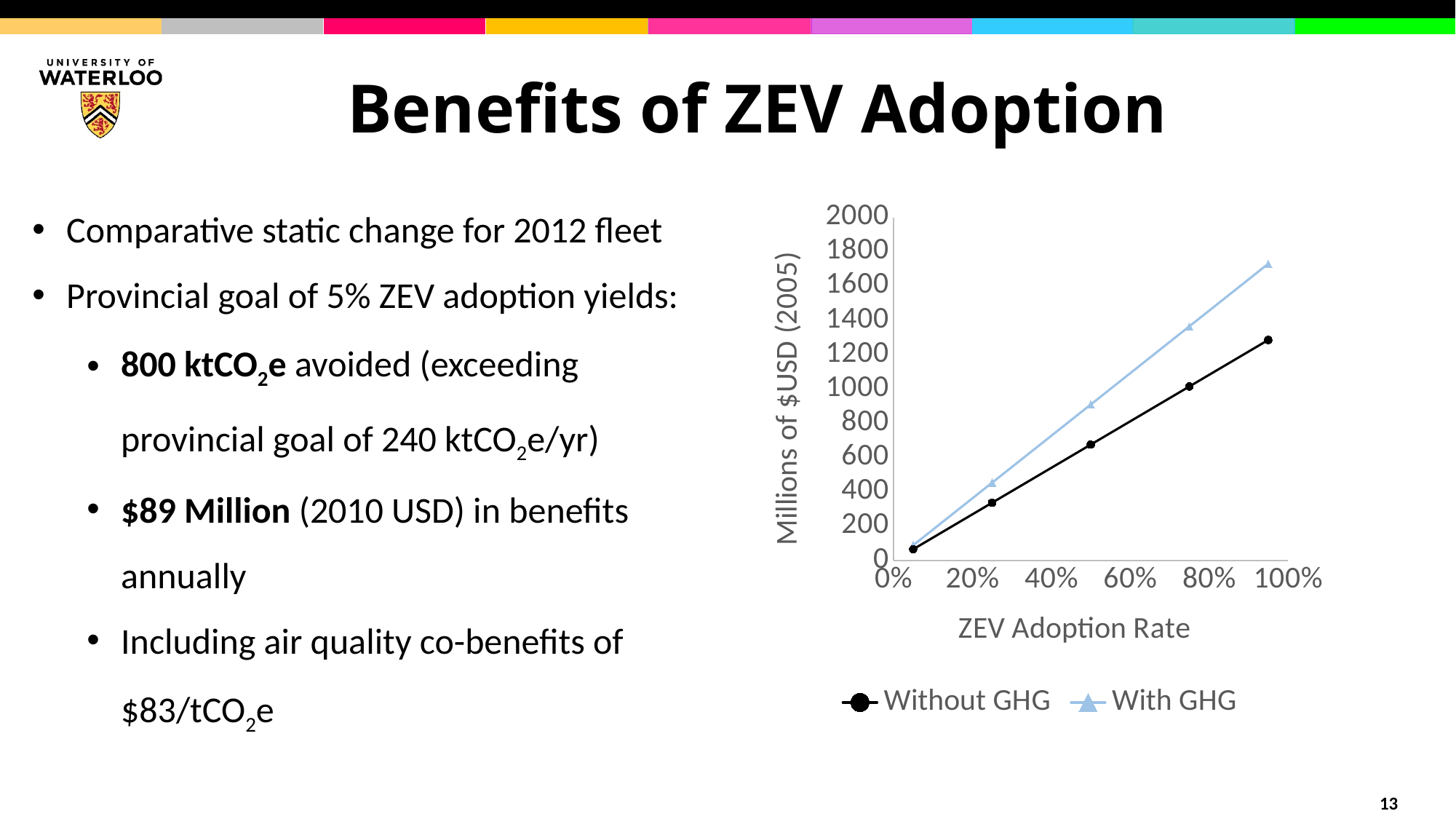
Is the value of the With GHG series at a 50% ZEV adoption rate greater or less than 1000? less Do the values for the With GHG series rise or fall as the ZEV adoption rate increases? rise What are the two series named in the chart legend? Without GHG and With GHG What is the title of the chart's x axis? ZEV Adoption Rate Do the values for the Without GHG series rise or fall as the ZEV adoption rate increases? rise At high ZEV adoption rates, which series has the larger value, With GHG or Without GHG? With GHG How many data points are plotted for the Without GHG series? 5 Is the highest value of the Without GHG series greater or less than 1000? greater How many series does the chart legend list? 2 Is the value of the Without GHG series at a 50% ZEV adoption rate greater or less than 800? less What kind of chart is shown on the slide? line chart